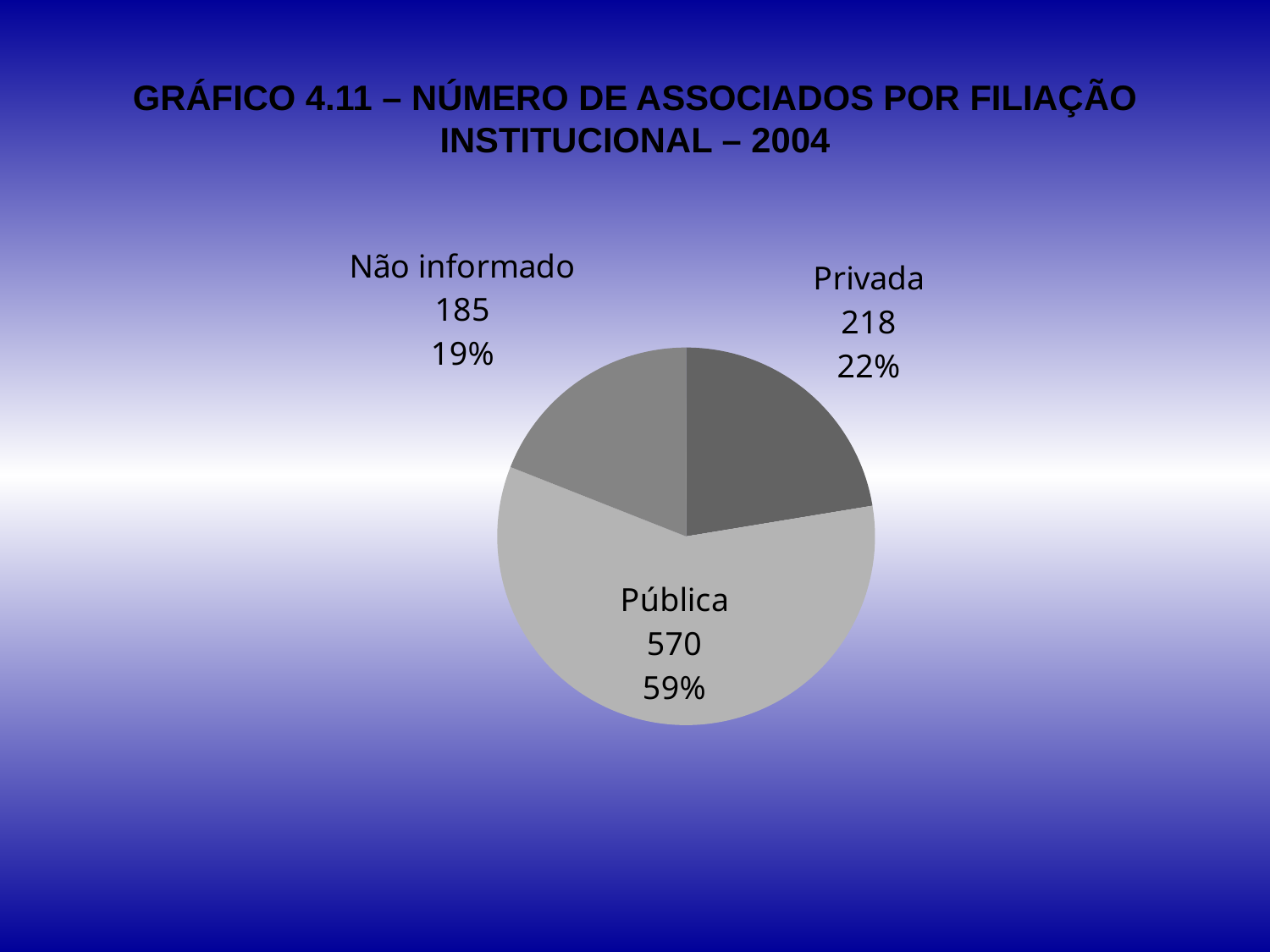
Which category has the largest slice? Pública What is the difference between the values for Pública and Privada? 352 Which is larger, the value for Privada or the value for Não informado? Privada What is the number of associates for Pública? 570 What year does the chart title refer to? 2004 What is the number of associates for Não informado? 185 Which category has the smallest slice? Não informado What share of the pie does Privada represent? 22% What is the number of associates for Privada? 218 What kind of chart is shown on the slide? pie chart What share of the pie does Pública represent? 59% How many slices does the pie chart have? 3